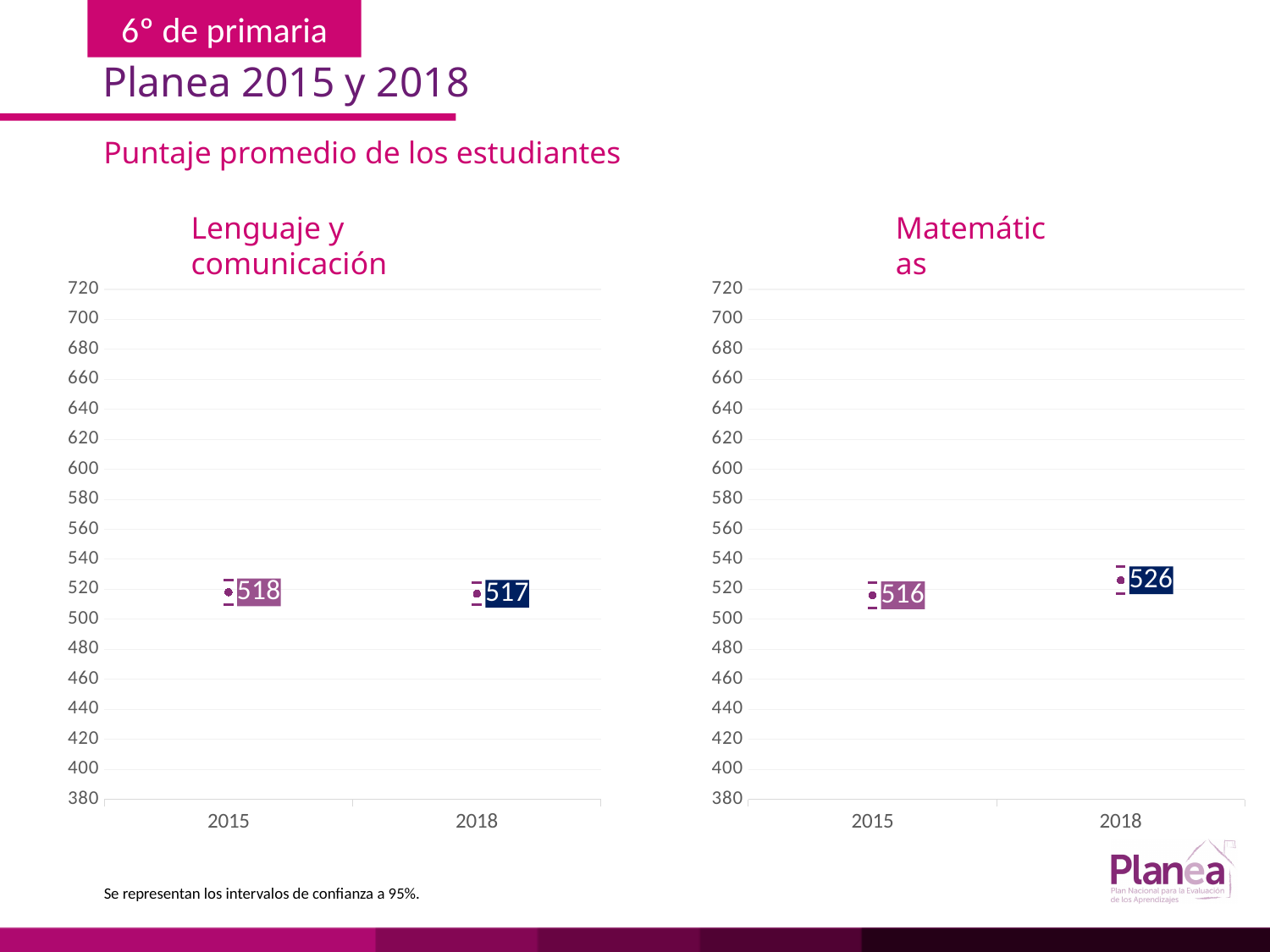
In the Lenguaje y comunicación chart, what is the difference between the 2015 and 2018 scores? 1 In the Matemáticas chart, what is the average score for 2018? 526 In the Matemáticas chart, what is the average score for 2015? 516 In the Matemáticas chart, which year has the lower average score? 2015 In the Matemáticas chart, is the 2018 score greater or less than 520? greater In the Matemáticas chart, which year has the higher average score? 2018 What is the subtitle shown above the two charts? Puntaje promedio de los estudiantes In the Matemáticas chart, do the scores rise or fall from 2015 to 2018? rise In the Lenguaje y comunicación chart, what is the average score for 2015? 518 In the Matemáticas chart, by how many points did the average score change from 2015 to 2018? 10 In the Lenguaje y comunicación chart, what is the average score for 2018? 517 How many years are plotted in the Lenguaje y comunicación chart? 2